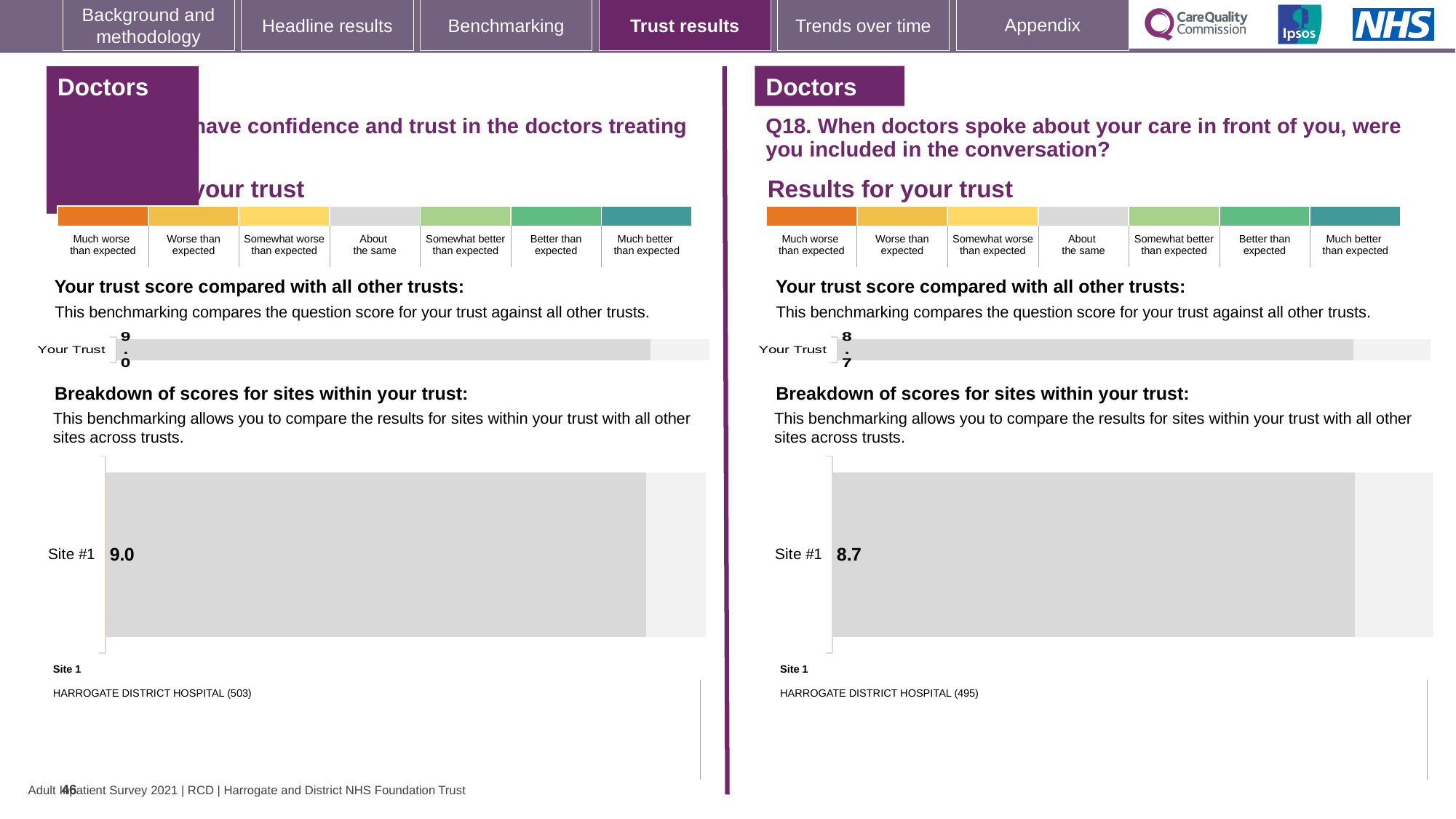
What is the difference between the Site #1 score on the left half of the slide and the Site #1 score on the right half (Q18)? 0.3 In the left 'Breakdown of scores for sites within your trust' chart, what is the score for Site #1? 9.0 How many sites are shown in the left 'Breakdown of scores for sites within your trust' chart? 1 Which hospital is listed as Site 1 on the left half of the slide? HARROGATE DISTRICT HOSPITAL (503) How many sites are shown in the right (Q18) 'Breakdown of scores for sites within your trust' chart? 1 On the right half of the slide (Q18), what is the score shown for Your Trust? 8.7 On the left half of the slide, what is the score shown for Your Trust? 9.0 What type of chart is used to show the Site #1 score on the right half of the slide (Q18)? Bar chart Which is larger: the Your Trust score on the left half of the slide or the Your Trust score on the right half (Q18)? Left (9.0) Which hospital is listed as Site 1 on the right half of the slide (Q18)? HARROGATE DISTRICT HOSPITAL (495) In the right (Q18) 'Breakdown of scores for sites within your trust' chart, what is the score for Site #1? 8.7